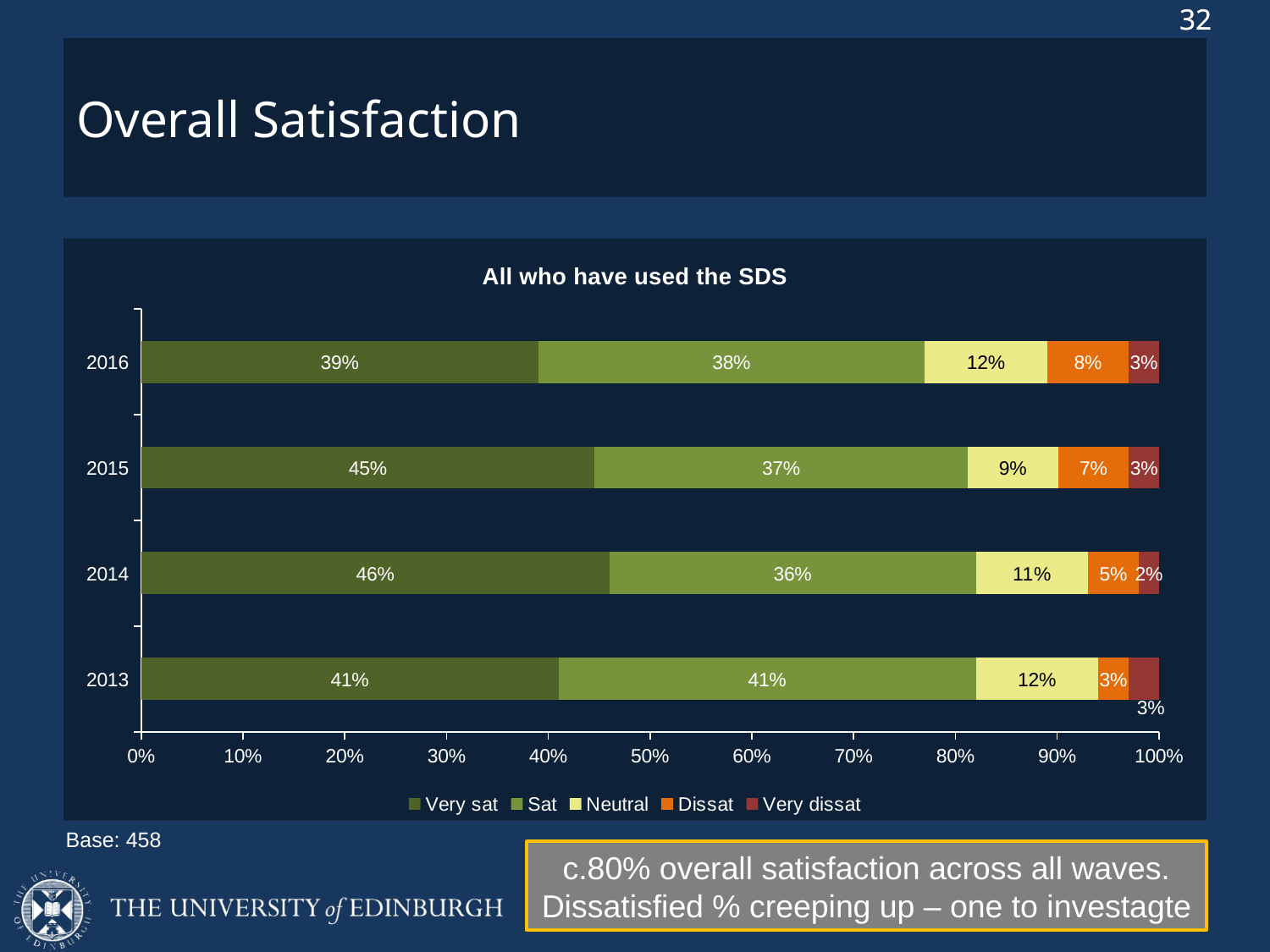
What is the Sat value for 2013? 41% What is the Dissat value for 2014? 5% How many series does the legend list? 5 What is the Neutral value for 2015? 9% What is the Very sat value for 2016? 39% What is the difference between the Very sat values for 2015 and 2016? 6% Which year has the lowest Dissat value? 2013 How many years are shown on the chart? 4 Is the Dissat value larger for 2016 or for 2015? 2016 What is the title of the chart? All who have used the SDS Which year has the highest Very sat value? 2014 What kind of chart is shown on the slide? Stacked bar chart